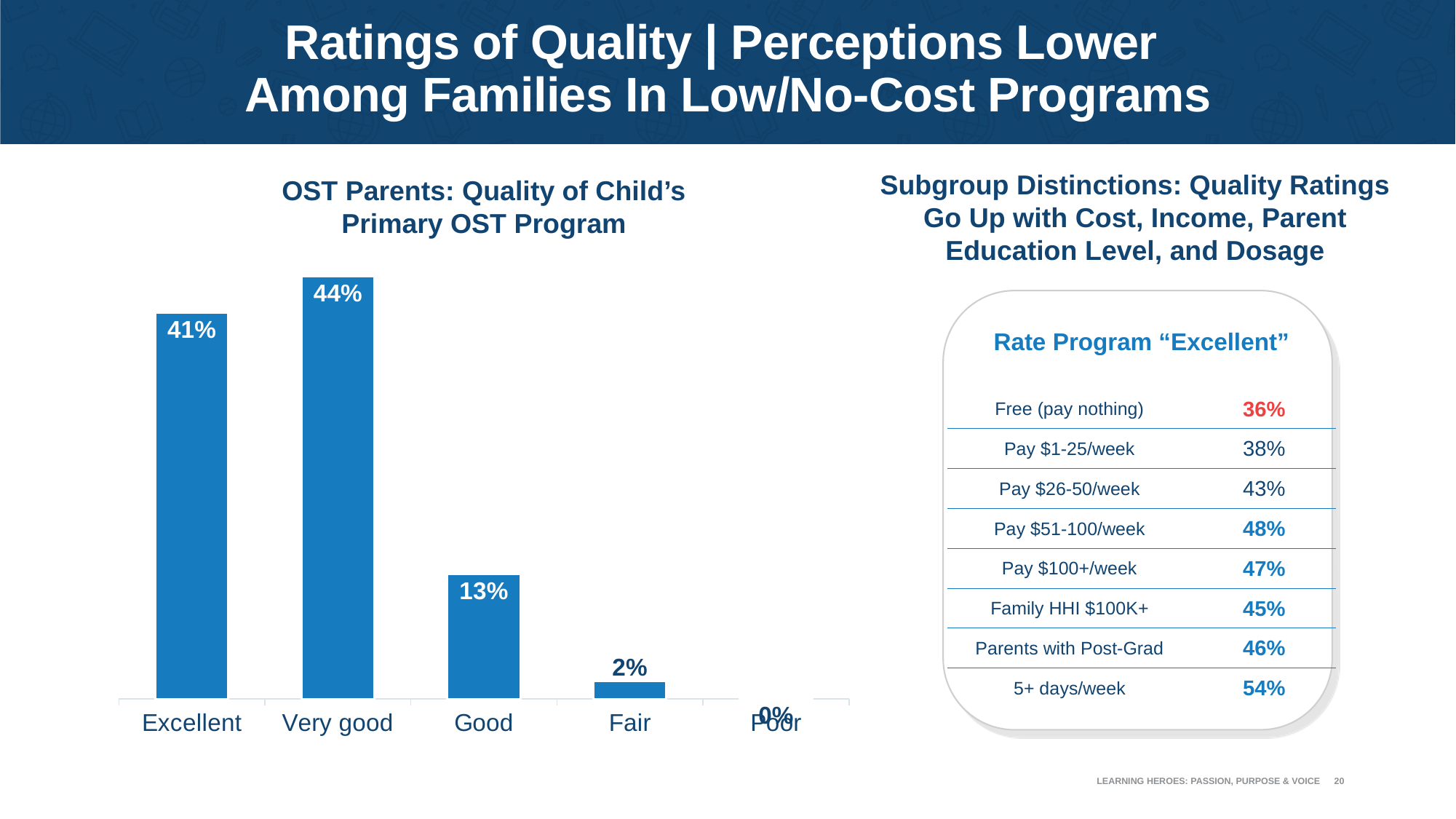
What is the difference in percentage points between the Very good and Excellent ratings? 3 Which rating category has the highest percentage in the bar chart? Very good What percentage of OST parents rated their child's primary OST program as Fair? 2% Which rating category has the lowest percentage in the bar chart? Poor What percentage of OST parents rated their child's primary OST program as Very good? 44% What percentage of OST parents rated their child's primary OST program as Good? 13% How many rating categories are shown in the bar chart? 5 What type of chart is used to show the quality ratings of the child's primary OST program? Bar chart Which is larger, the percentage for Excellent or the percentage for Good? Excellent What percentage of OST parents rated their child's primary OST program as Excellent? 41% What percentage of OST parents rated their child's primary OST program as Poor? 0% What is the difference in percentage points between the Good and Fair ratings? 11